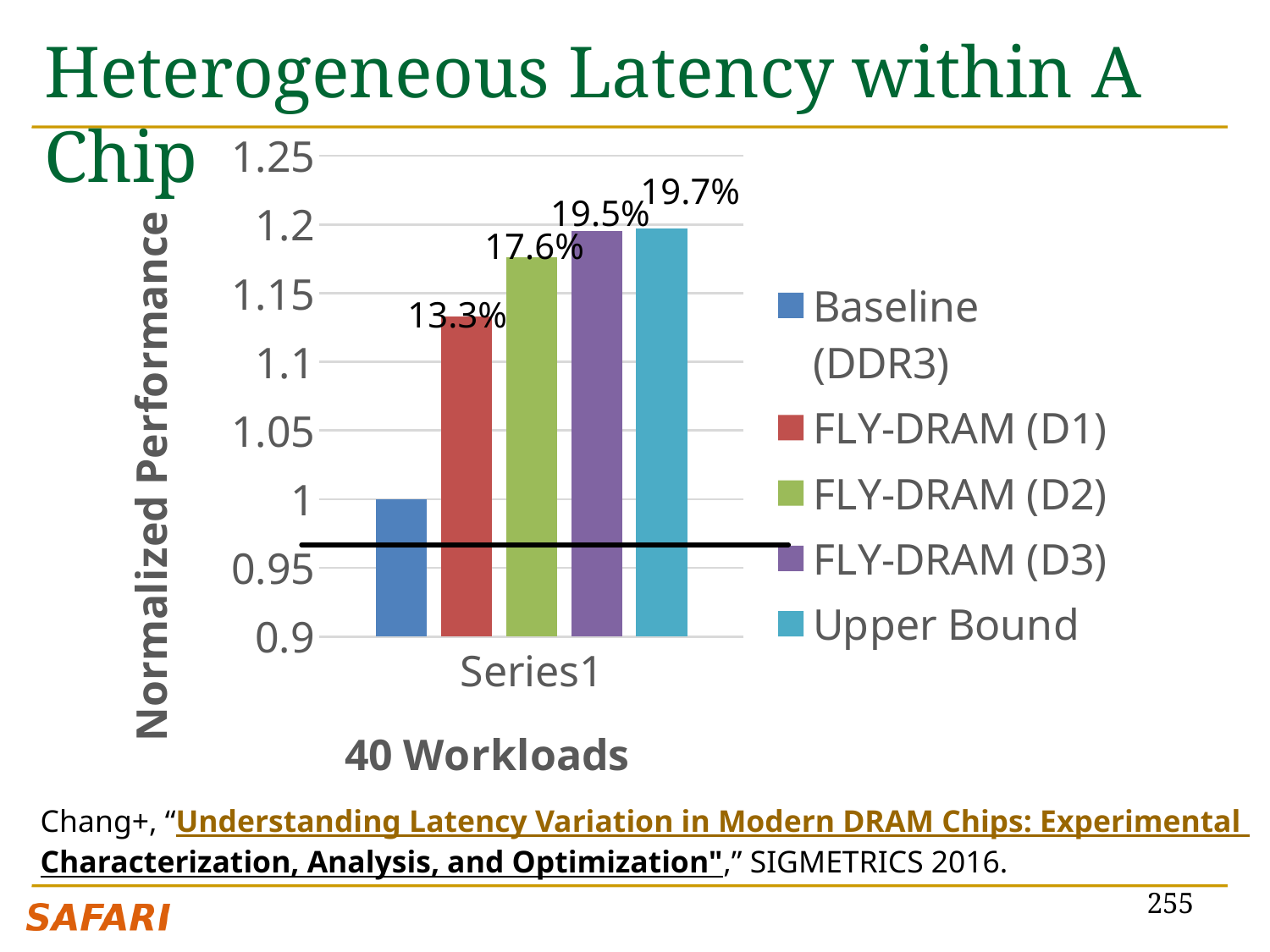
What data label is printed above the FLY-DRAM (D2) bar? 17.6% Is the normalized performance for FLY-DRAM (D1) greater or less than 1.1? greater What data label is printed above the FLY-DRAM (D1) bar? 13.3% What data label is printed above the FLY-DRAM (D3) bar? 19.5% What is the label of the y axis? Normalized Performance What is the normalized performance of the Baseline (DDR3) bar? 1 Which series has the highest data label? Upper Bound Which series has the lowest normalized performance? Baseline (DDR3) Which is larger, the data label for FLY-DRAM (D2) or for FLY-DRAM (D1)? FLY-DRAM (D2) What data label is printed above the Upper Bound bar? 19.7% What kind of chart is shown on the slide? bar chart How many series does the legend list? 5